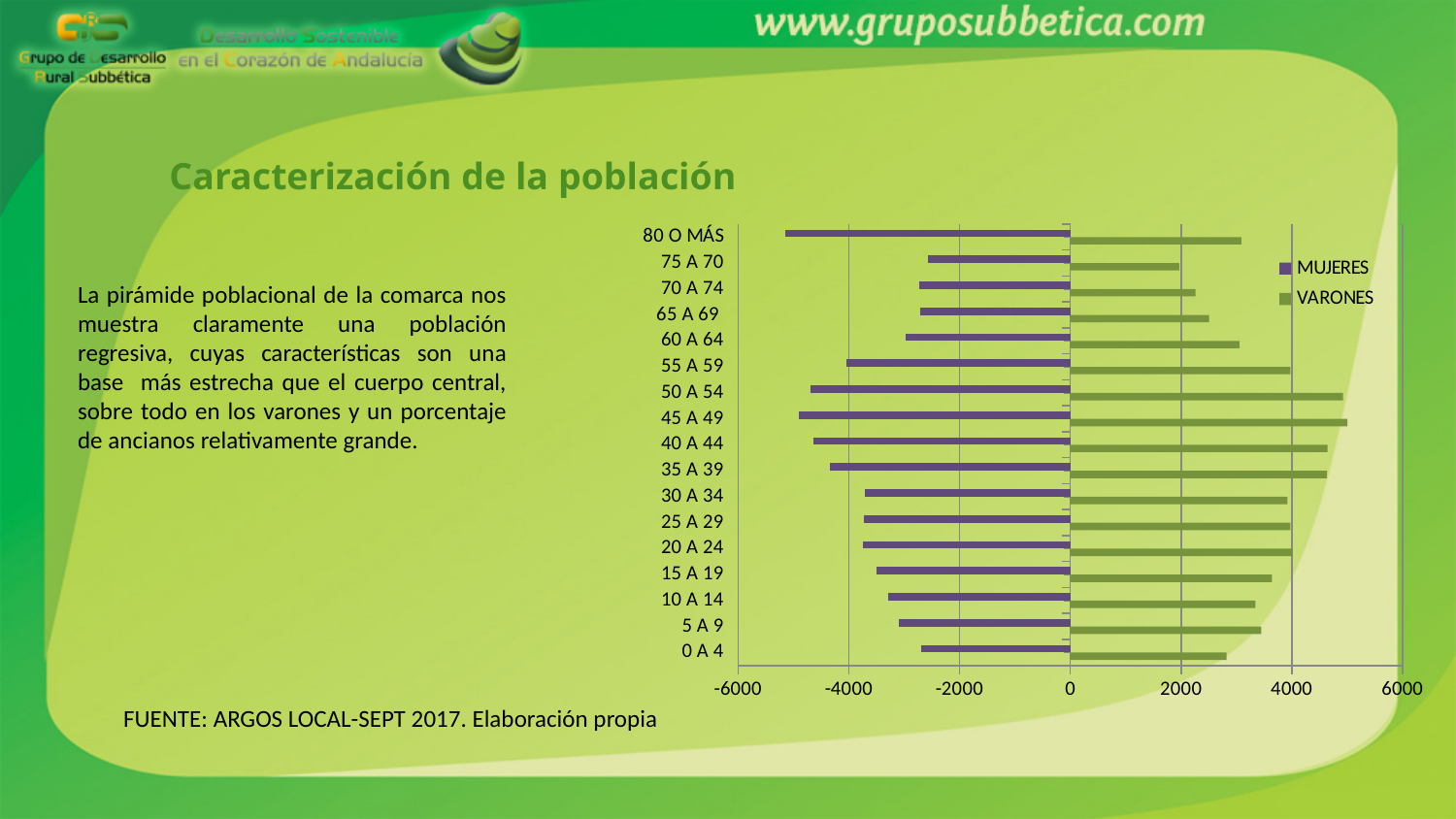
Which series is plotted with purple bars? MUJERES Is the VARONES value for 75 A 70 greater or less than 4000? less How many age-group categories are plotted on the chart? 17 Is the VARONES value for 15 A 19 greater or less than 4000? less What are the two series named in the chart legend? MUJERES and VARONES Is the MUJERES value for 80 O MÁS greater or less than -4000? less What kind of chart is shown on the slide? bar chart Which VARONES bar is longer, 45 A 49 or 0 A 4? 45 A 49 How many series does the chart legend list? 2 Which MUJERES bar is longer, 50 A 54 or 25 A 29? 50 A 54